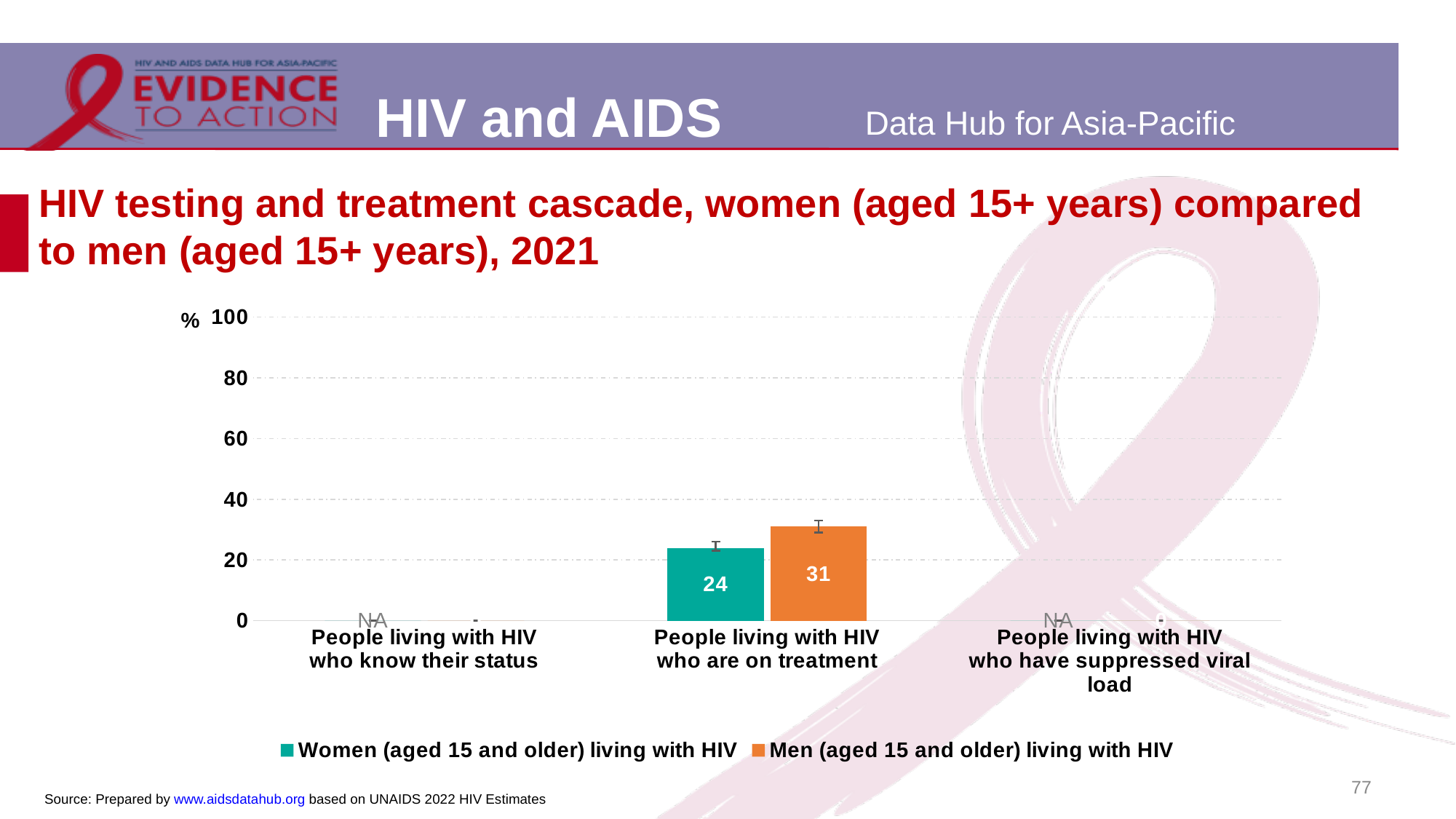
For people living with HIV who are on treatment, which series has the larger value, women or men? Men (aged 15 and older) living with HIV How many categories are shown on the x axis of the chart? 3 How many series does the legend list? 2 What is shown for the category 'People living with HIV who know their status'? NA What is the difference between the men's and women's values for people living with HIV who are on treatment? 7 What unit is shown on the y axis of the chart? % Is the value for women living with HIV who are on treatment greater or less than 20? greater Is the value for men living with HIV who are on treatment greater or less than 40? less What colour represents women (aged 15 and older) living with HIV in the chart? Teal What is the value for men (aged 15 and older) living with HIV who are on treatment? 31 What is the value for women (aged 15 and older) living with HIV who are on treatment? 24 What kind of chart is shown on the slide? Bar chart